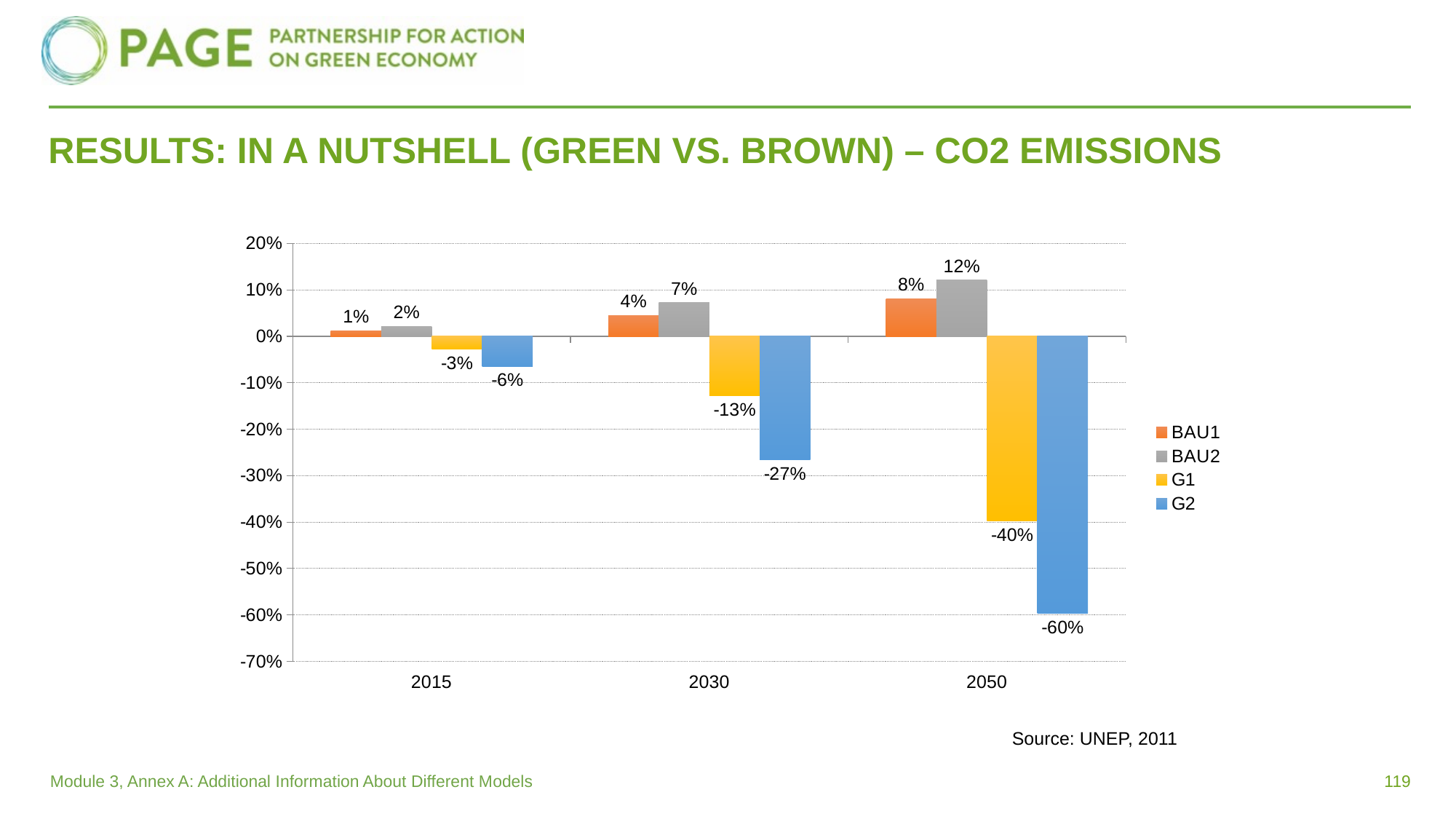
Do the G2 values rise or fall from 2015 to 2050? Fall What is the value for G2 in 2050? -60% What is the value for G1 in 2015? -3% Which series has the lowest value in 2030? G2 Which series has the highest value in 2050? BAU2 What colour are the G1 bars? Yellow How many series does the legend list? 4 Which is larger, the G1 value in 2030 or the G1 value in 2015? G1 in 2015 What is the difference between the BAU2 and BAU1 values in 2050? 4% What is the value for BAU2 in 2030? 7% What kind of chart is shown on the slide? Bar chart How many year categories are shown on the x axis? 3